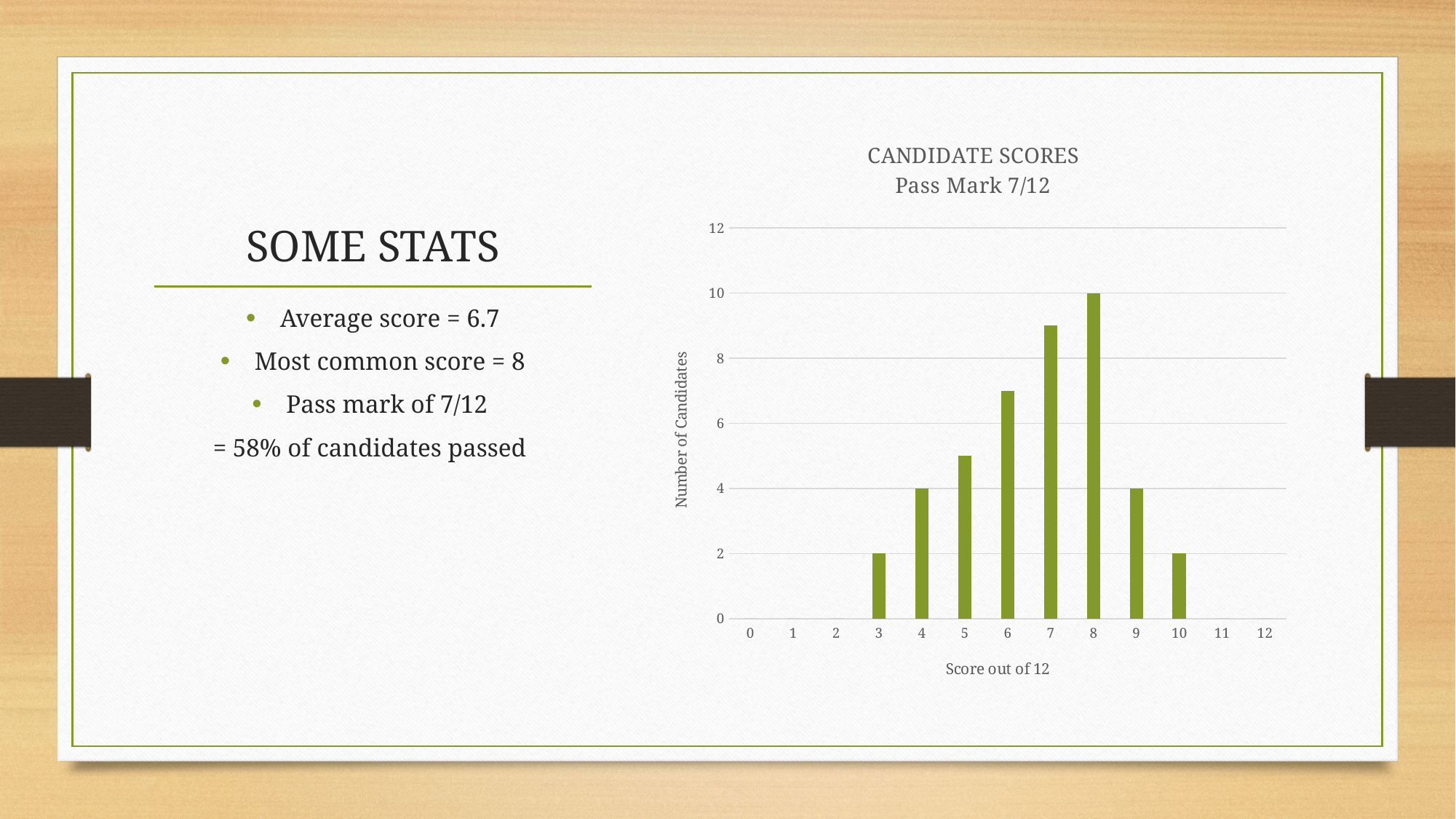
How many candidates scored 8 out of 12? 10 What is the title of the chart? CANDIDATE SCORES Pass Mark 7/12 How many scores on the x axis have a bar plotted? 8 Is the number of candidates who scored 7 greater or less than 8? greater What type of chart is shown on the slide? bar chart Which score has the highest number of candidates? 8 Which score has more candidates, 7 or 9? 7 How many candidates scored 10 out of 12? 2 Is the number of candidates who scored 5 greater or less than 6? less How many candidates scored 4 out of 12? 4 What is the difference between the number of candidates who scored 8 and the number who scored 3? 8 What is the label of the vertical axis of the chart? Number of Candidates